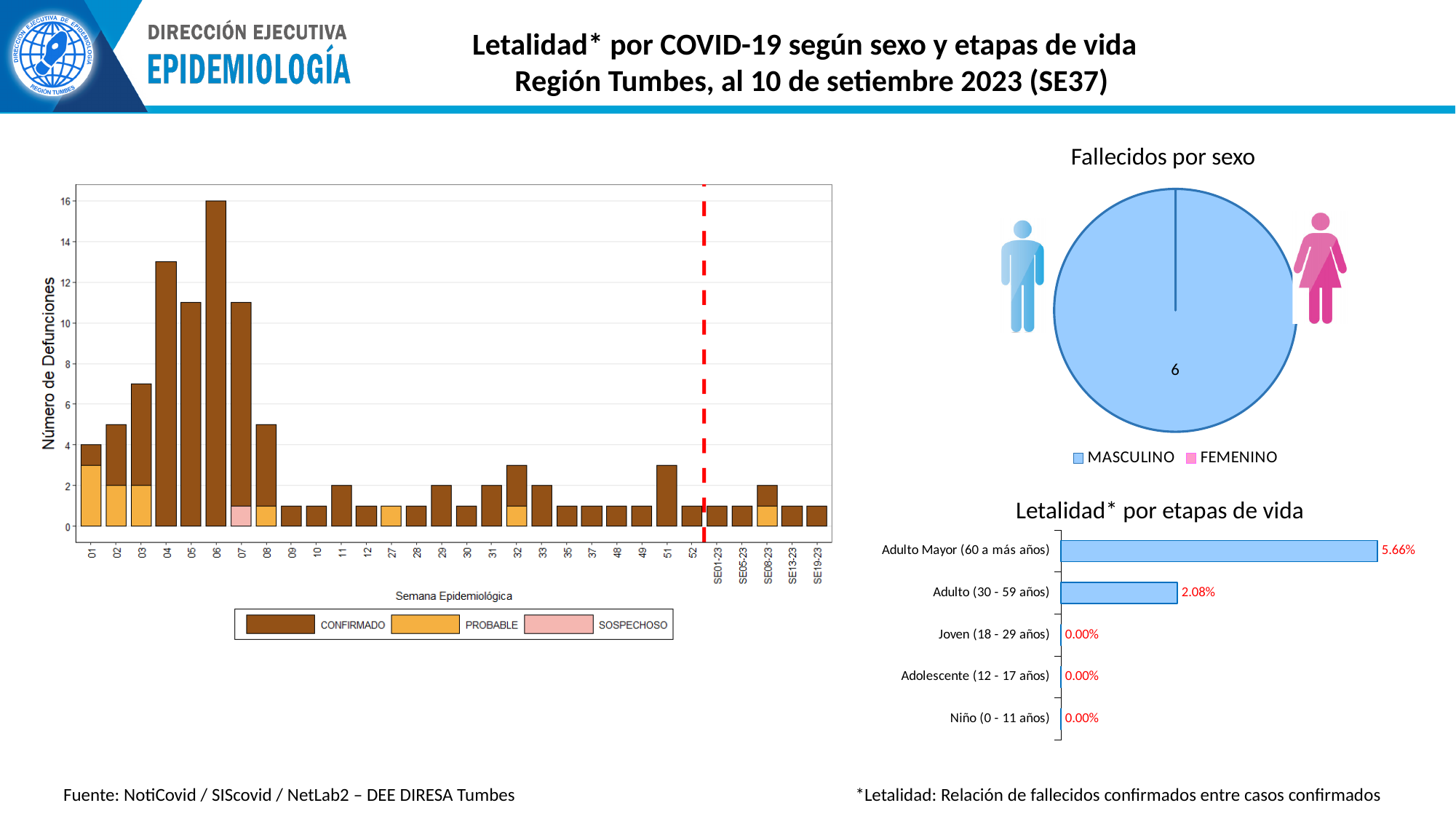
In the 'Letalidad* por etapas de vida' chart, what is the value for Adulto (30 - 59 años)? 2.08% In the 'Letalidad* por etapas de vida' chart, what is the value for Adulto Mayor (60 a más años)? 5.66% In the 'Fallecidos por sexo' chart, what value is shown for MASCULINO? 6 In the chart on the left (Número de Defunciones by Semana Epidemiológica), which week has the highest total number of deaths? 06 What kind of chart is 'Fallecidos por sexo'? Pie chart In the 'Letalidad* por etapas de vida' chart, which age group has the highest value? Adulto Mayor (60 a más años) How many series does the legend of the 'Fallecidos por sexo' chart list? 2 In the 'Letalidad* por etapas de vida' chart, how many age groups are shown? 5 In the 'Letalidad* por etapas de vida' chart, what is the value for Joven (18 - 29 años)? 0.00% In the chart on the left (Número de Defunciones by Semana Epidemiológica), is the total for week 04 greater or less than 12? greater How many series does the legend of the chart on the left (Número de Defunciones by Semana Epidemiológica) list? 3 In the 'Letalidad* por etapas de vida' chart, what is the difference between the values for Adulto Mayor (60 a más años) and Adulto (30 - 59 años)? 3.58%